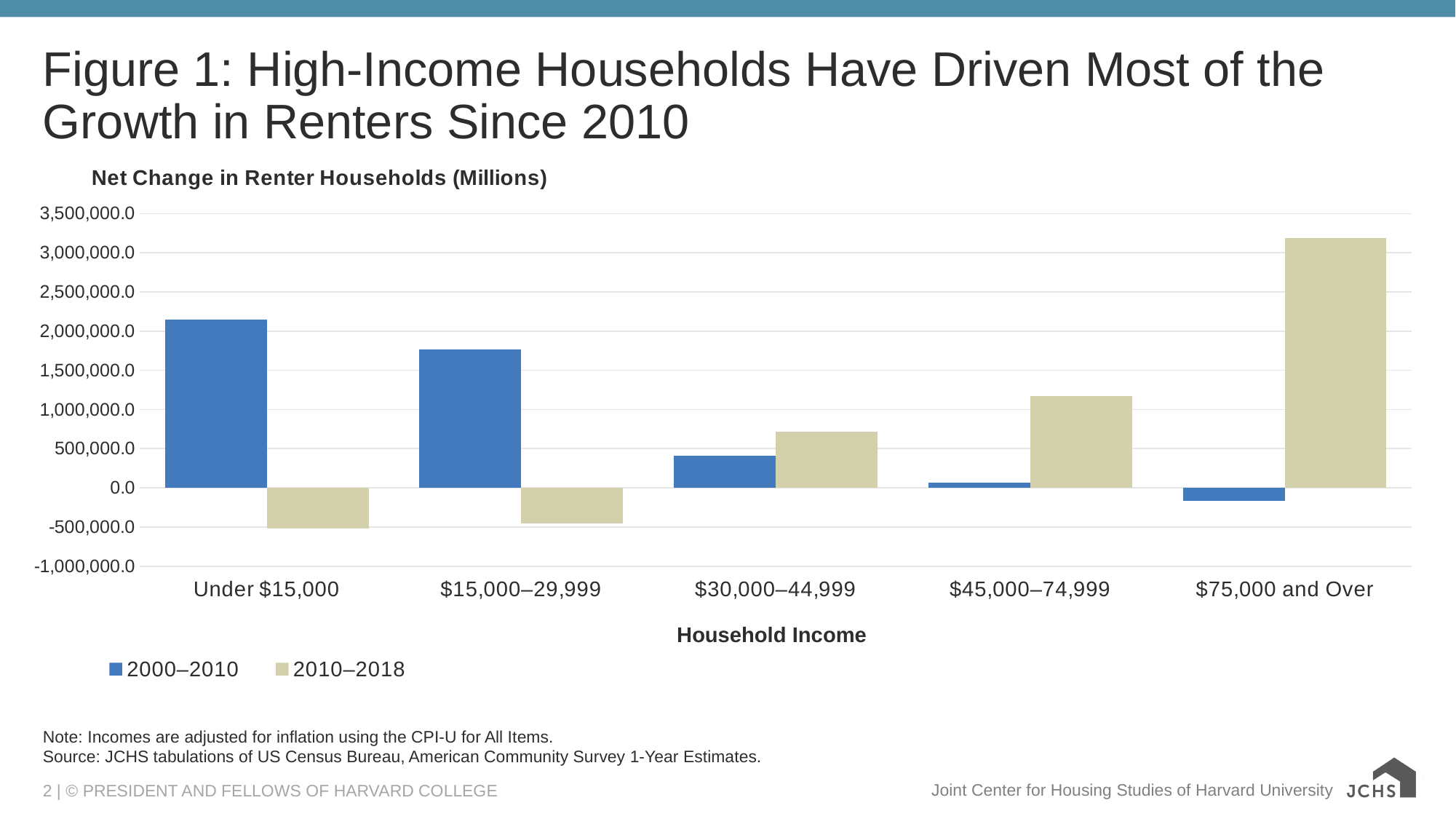
Is the 2010–2018 value for $75,000 and Over greater or less than 3,000,000.0? greater Which household income category has the lowest value for the 2000–2010 series? $75,000 and Over Is the 2000–2010 value for Under $15,000 greater or less than 2,000,000.0? greater Do the 2010–2018 values rise or fall as household income increases along the x axis? rise Is the 2010–2018 value for $45,000–74,999 greater or less than 1,000,000.0? greater What kind of chart is shown on the slide? bar chart What is the title of the vertical axis measure shown above the chart? Net Change in Renter Households (Millions) How many series does the legend list? 2 Which household income category has the highest value for the 2000–2010 series? Under $15,000 How many household income categories are shown on the x axis? 5 Which is larger: the 2000–2010 value for Under $15,000 or the 2010–2018 value for $75,000 and Over? the 2010–2018 value for $75,000 and Over Which household income category has the highest value for the 2010–2018 series? $75,000 and Over